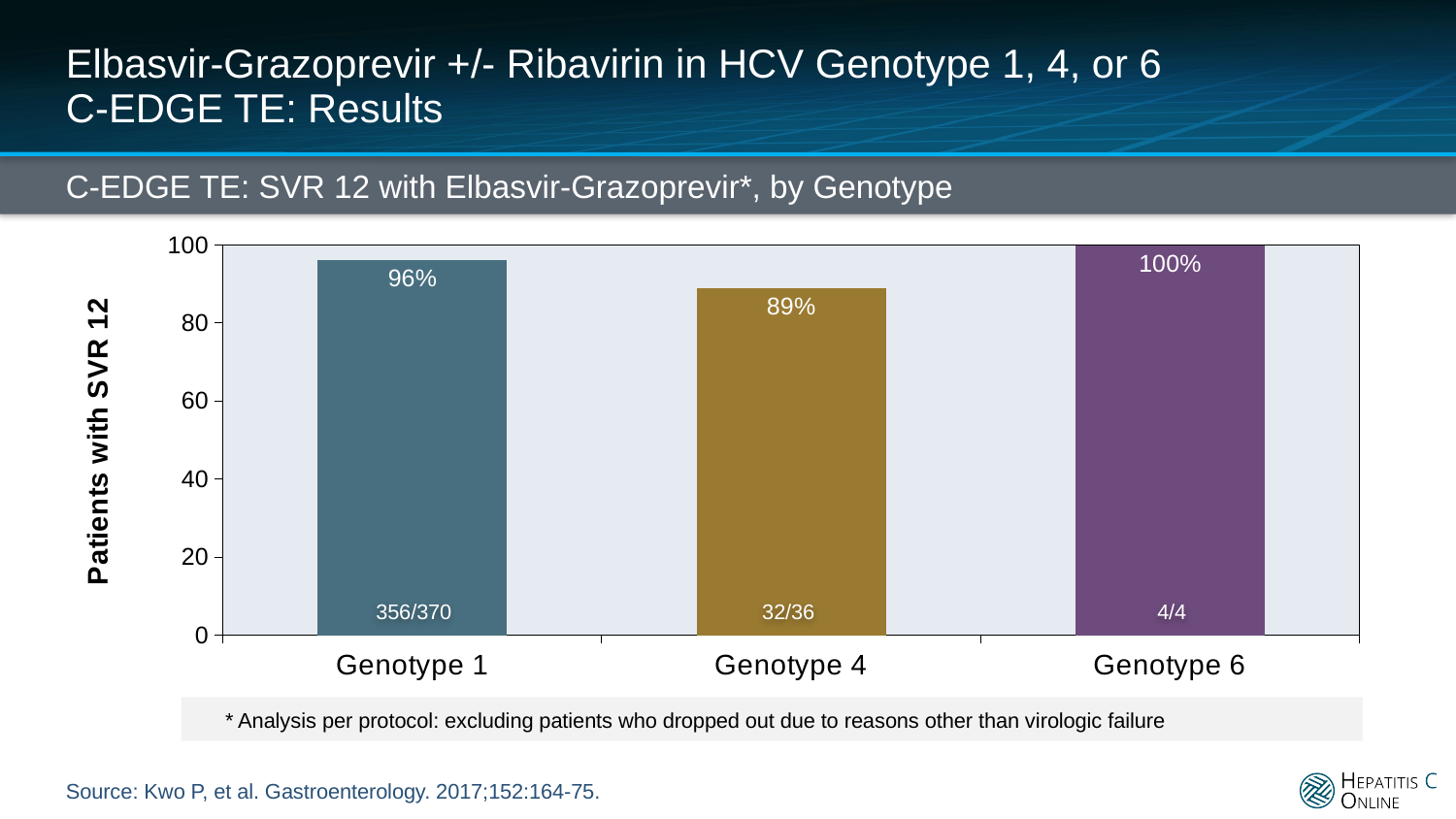
What fraction of patients achieved SVR 12 in the Genotype 4 group? 32/36 What is the SVR 12 rate for Genotype 1? 96% Which genotype has the highest SVR 12 rate? Genotype 6 What is the label of the y-axis? Patients with SVR 12 Which genotype has the lowest SVR 12 rate? Genotype 4 Which has a higher SVR 12 rate, Genotype 1 or Genotype 4? Genotype 1 What fraction of patients achieved SVR 12 in the Genotype 1 group? 356/370 What type of chart is shown on the slide? Bar chart How many genotype categories are shown in the chart? 3 What is the difference in SVR 12 rate between Genotype 1 and Genotype 4? 7% What is the SVR 12 rate for Genotype 4? 89% What is the SVR 12 rate for Genotype 6? 100%